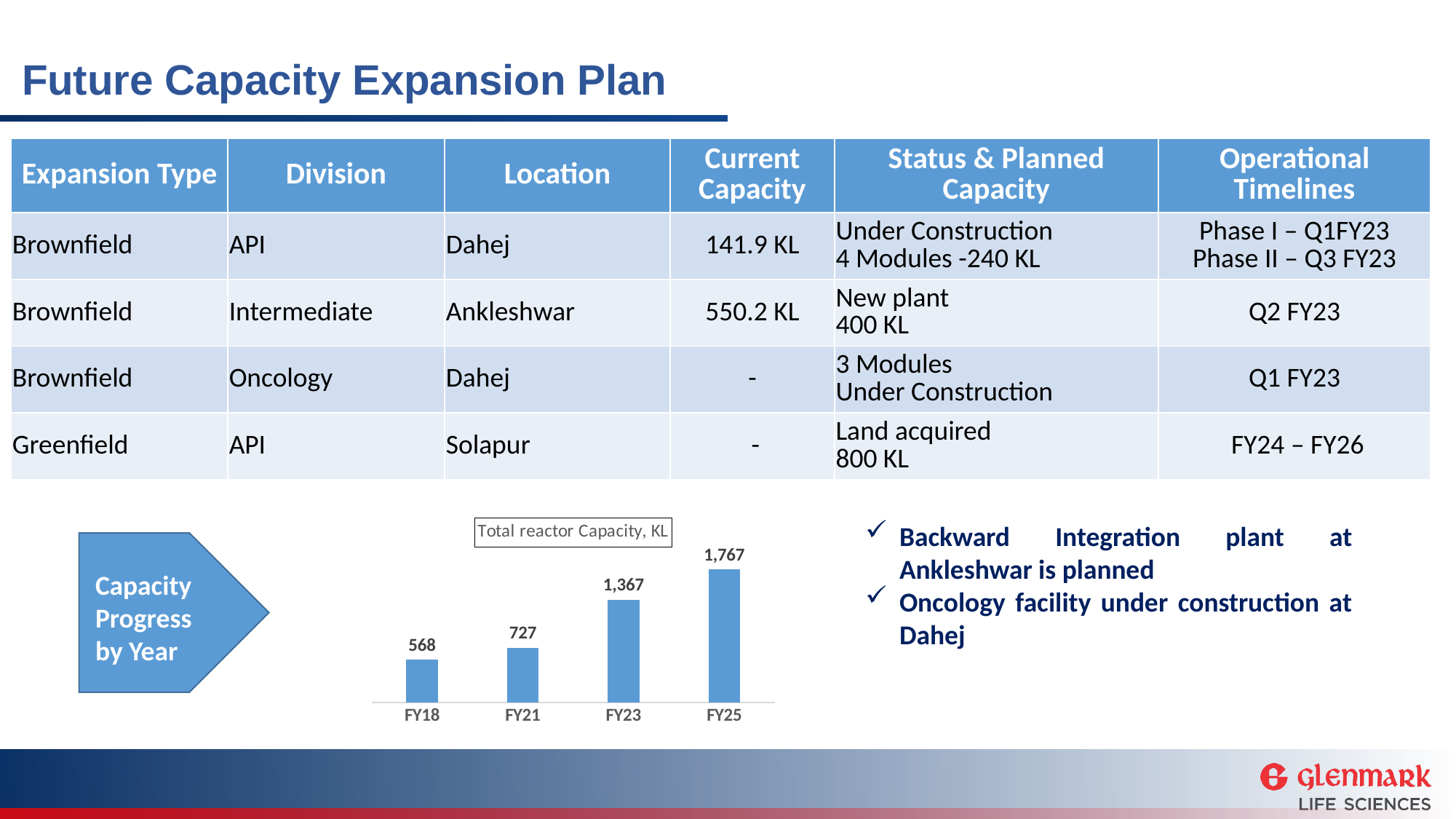
What is the difference in total reactor capacity between FY25 and FY23? 400 Does the total reactor capacity rise or fall from FY18 to FY25? Rise What is the total reactor capacity shown for FY18? 568 What is the difference in total reactor capacity between FY21 and FY18? 159 What is the total reactor capacity shown for FY25? 1,767 What is the total reactor capacity shown for FY21? 727 Which year has the lowest total reactor capacity in the chart? FY18 Which is larger, the total reactor capacity for FY23 or for FY21? FY23 Which year has the highest total reactor capacity in the chart? FY25 What is the total reactor capacity shown for FY23? 1,367 How many years are plotted in the total reactor capacity chart? 4 What kind of chart is used to show total reactor capacity by year? Bar chart